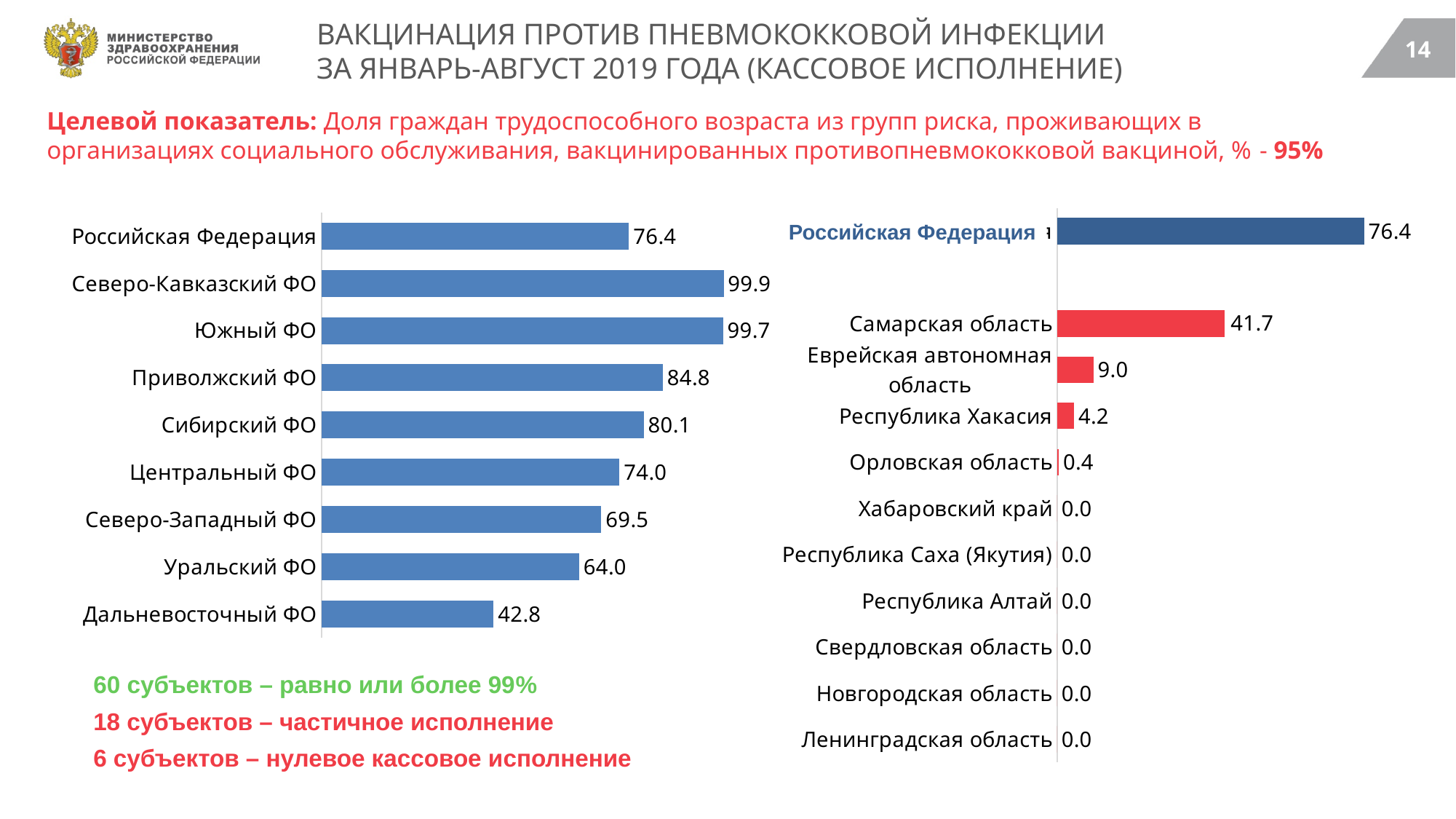
How many categories are shown on the left chart? 9 On the left chart, which federal district has the highest value? Северо-Кавказский ФО On the left chart, what is the difference between the values for Сибирский ФО and Уральский ФО? 16.1 What type of chart is the left chart? Bar chart On the right chart, what is the value for Самарская область? 41.7 On the left chart, which is larger: the value for Центральный ФО or Северо-Западный ФО? Центральный ФО How many categories are shown on the right chart? 11 On the right chart, what is the value for Республика Хакасия? 4.2 On the left chart, what is the value for Приволжский ФО? 84.8 On the left chart, what is the value for Дальневосточный ФО? 42.8 On the left chart, which category has the lowest value? Дальневосточный ФО On the right chart, what is the difference between the values for Самарская область and Еврейская автономная область? 32.7